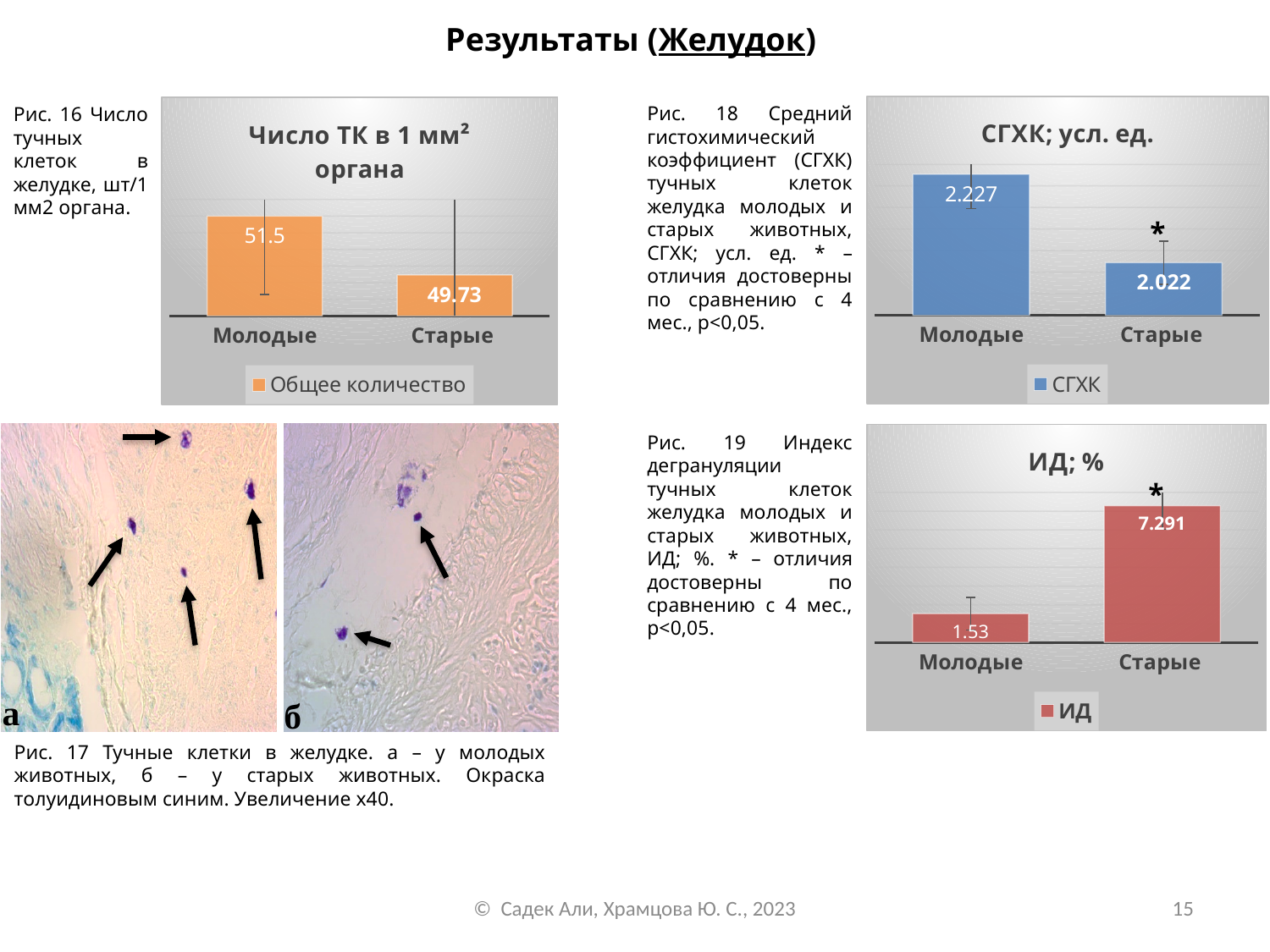
In the chart titled "ИД; %", what is the difference between the values for Старые and Молодые? 5.761 In the chart titled "Число ТК в 1 мм² органа", what is the value for Молодые? 51.5 In the chart titled "Число ТК в 1 мм² органа", what is the value for Старые? 49.73 In the chart titled "СГХК; усл. ед.", what is the value for Молодые? 2.227 In the chart titled "Число ТК в 1 мм² органа", what is the difference between the values for Молодые and Старые? 1.77 In the chart titled "ИД; %", what is the value for Старые? 7.291 In the chart titled "Число ТК в 1 мм² органа", which category has the higher value? Молодые In the chart titled "ИД; %", is the value for Молодые or Старые larger? Старые In the chart titled "СГХК; усл. ед.", what is the value for Старые? 2.022 In the chart titled "СГХК; усл. ед.", which category has the lower value? Старые In the chart titled "ИД; %", what is the value for Молодые? 1.53 What type of chart is the chart titled "ИД; %"? Bar chart